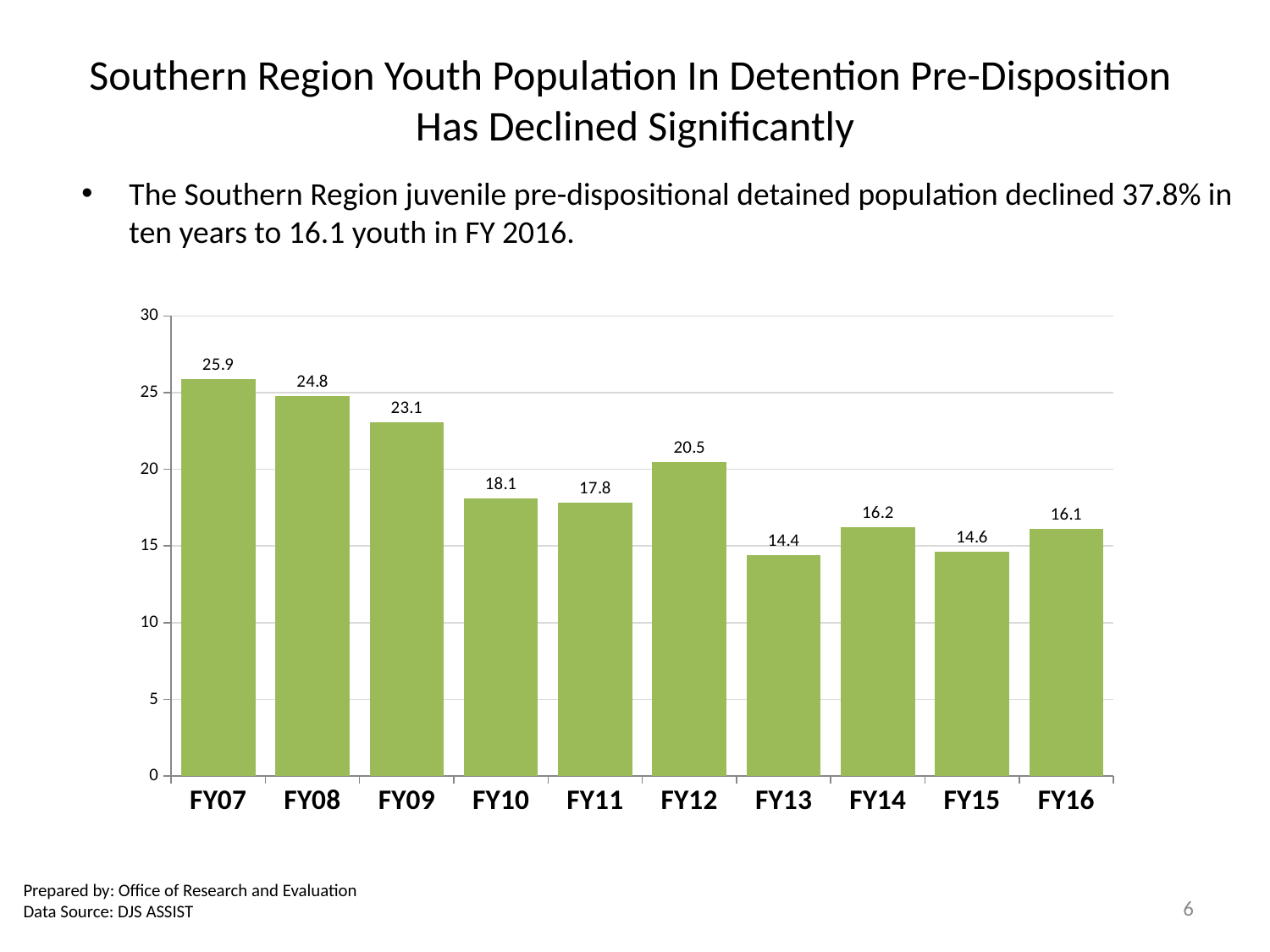
What kind of chart is shown on the slide? bar chart How many fiscal years are shown on the x axis? 10 What colour are the bars in the chart? green Which fiscal year has the lowest value? FY13 What is the value for FY16? 16.1 Which is larger, the value for FY11 or the value for FY12? FY12 Which fiscal year has the highest value? FY07 What is the value for FY12? 20.5 What is the value for FY07? 25.9 What is the difference between the values for FY07 and FY16? 9.8 Do the values generally rise or fall from FY07 to FY16? fall Is the value for FY09 greater or less than 20? greater